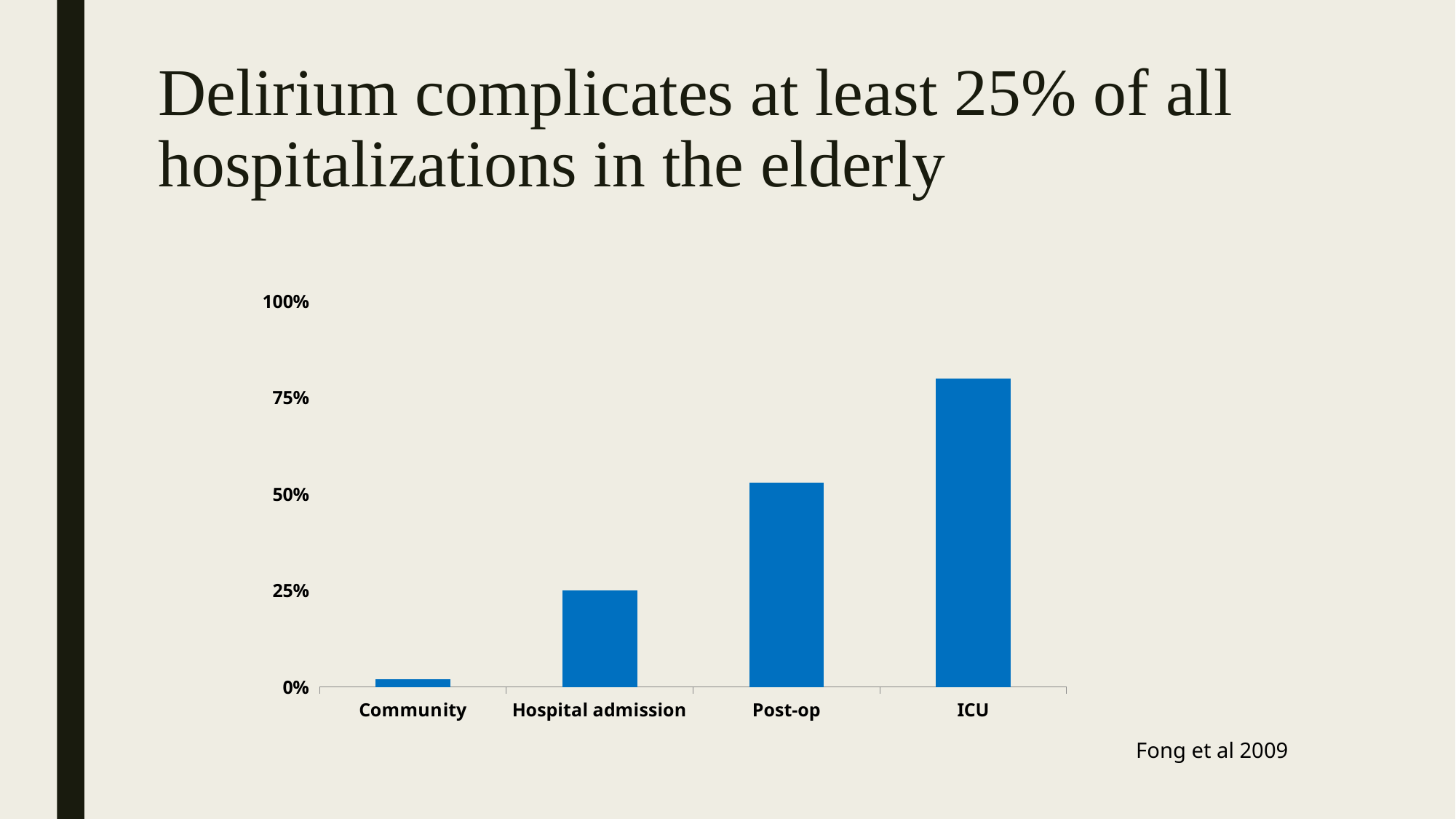
Is the value for ICU greater or less than 100%? less What source is cited below the chart? Fong et al 2009 Is the value for Community greater or less than 25%? less Which category has the highest value in the chart? ICU Which category has the lowest value in the chart? Community Do the values rise or fall from Community to ICU along the x axis? rise How many categories are shown on the x axis of the chart? 4 What kind of chart is shown on the slide? bar chart Is the value for ICU greater or less than 75%? greater Which is larger, the value for Post-op or the value for Hospital admission? Post-op What is the value for Hospital admission? 25%